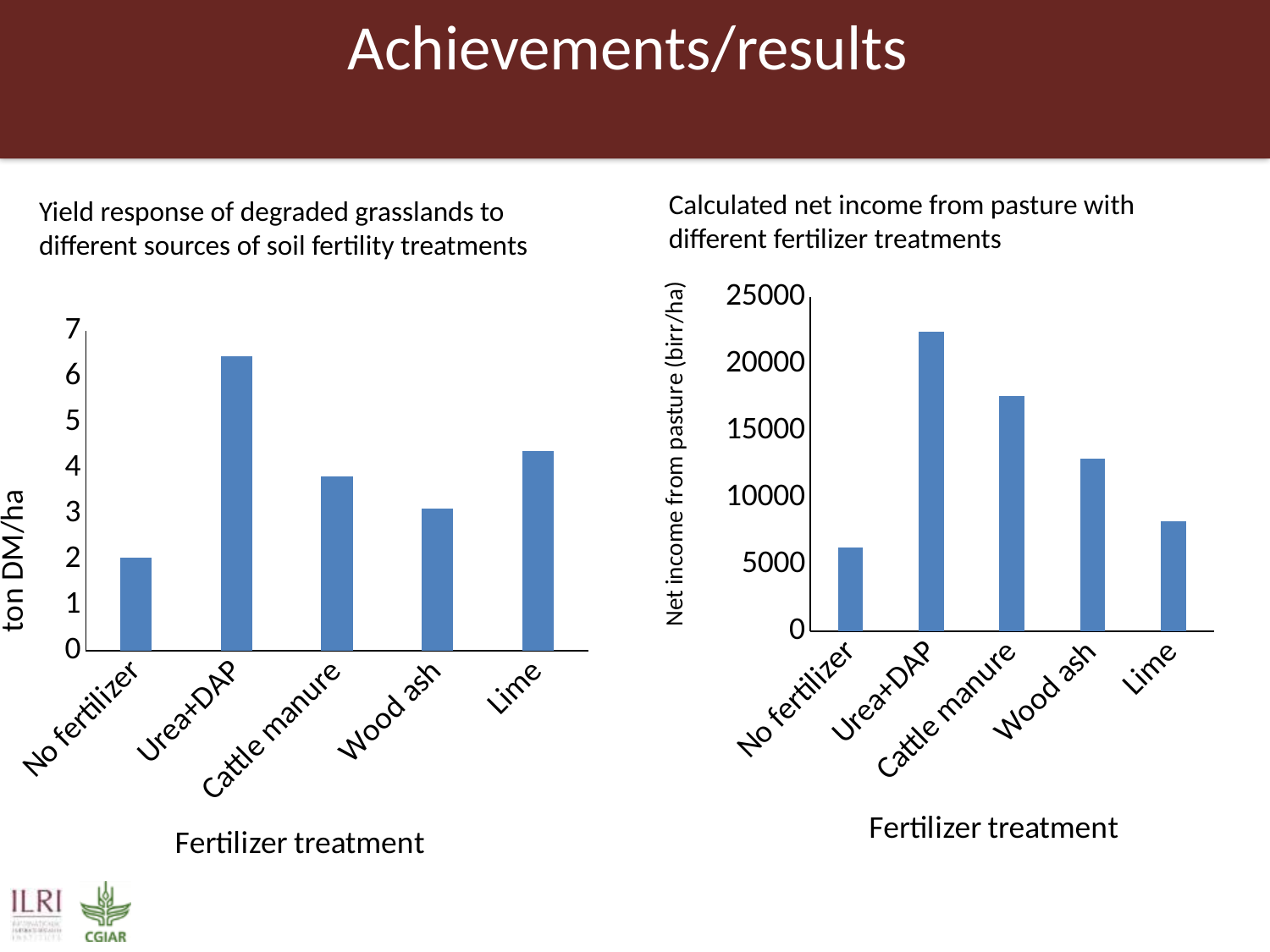
How many fertilizer treatments are shown in the left chart (Yield response of degraded grasslands)? 5 In the right chart (Calculated net income from pasture), which fertilizer treatment gives the lowest net income? No fertilizer In the left chart (Yield response of degraded grasslands), is the value for Urea+DAP greater or less than 6 ton DM/ha? greater In the left chart (Yield response of degraded grasslands), is the value for Wood ash greater or less than 4 ton DM/ha? less In the right chart (Calculated net income from pasture), which is larger, the net income for Wood ash or for Lime? Wood ash In the right chart (Calculated net income from pasture), is the value for Lime greater or less than 10000 birr/ha? less In the right chart (Calculated net income from pasture), which fertilizer treatment gives the highest net income? Urea+DAP In the left chart (Yield response of degraded grasslands), which fertilizer treatment has the lowest yield? No fertilizer What type of chart is the right chart (Calculated net income from pasture)? Bar chart In the left chart (Yield response of degraded grasslands), which fertilizer treatment has the highest yield? Urea+DAP In the left chart (Yield response of degraded grasslands), which is larger, the yield for Lime or for Cattle manure? Lime